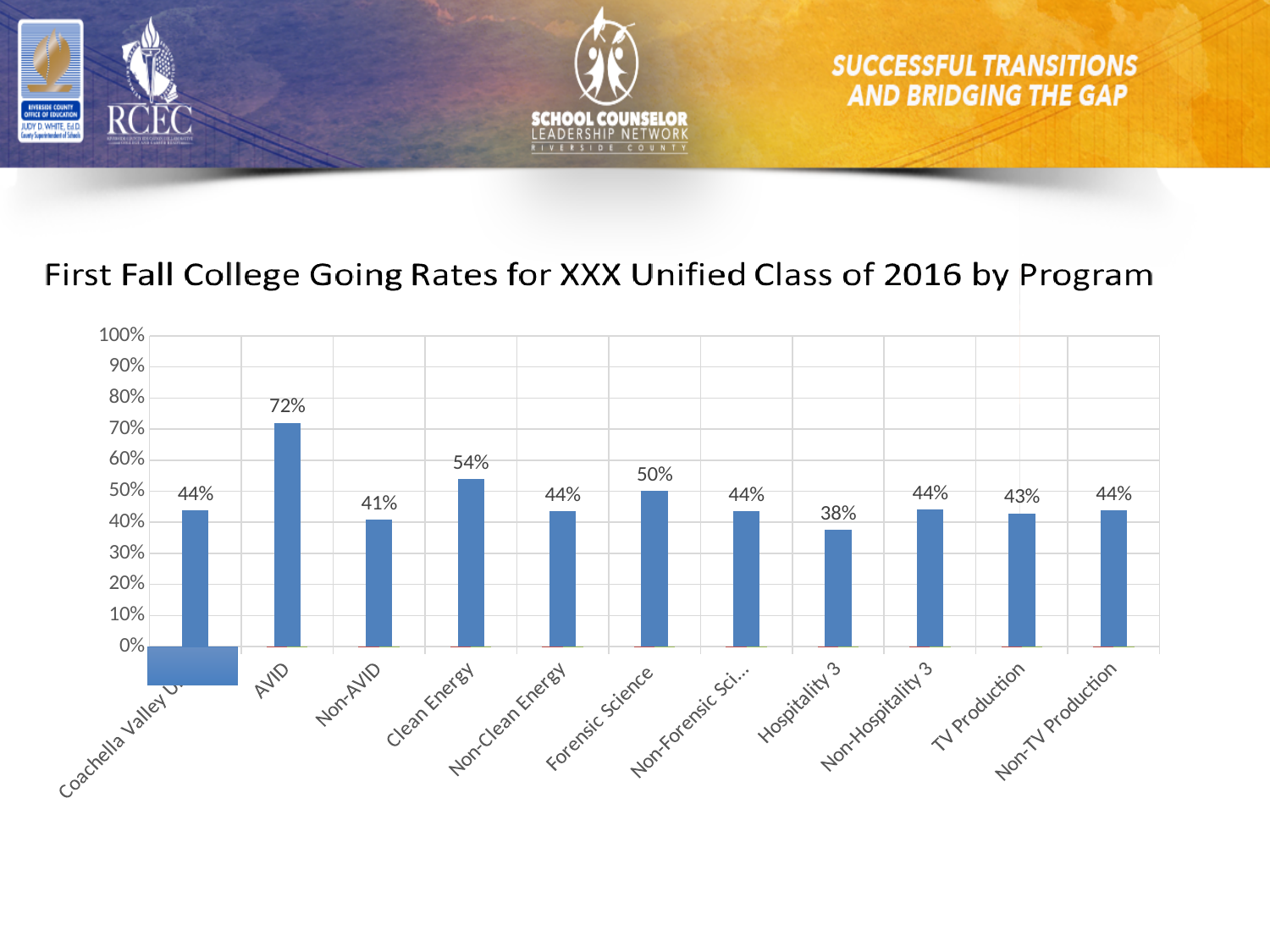
What is the difference in percentage points between AVID and Non-AVID? 31 percentage points What kind of chart is shown on the slide? Bar chart What is the difference in percentage points between Clean Energy and Non-Clean Energy? 10 percentage points Which program has the highest college going rate? AVID What is the value shown for Hospitality 3? 38% What is the value shown for Clean Energy? 54% Is the value for Hospitality 3 greater or less than 40%? less Which is larger, the value for Forensic Science or the value for Non-Forensic Science? Forensic Science What is the value shown for TV Production? 43% Which program has the lowest college going rate? Hospitality 3 How many program categories are shown on the chart? 11 What is the first fall college going rate for AVID? 72%